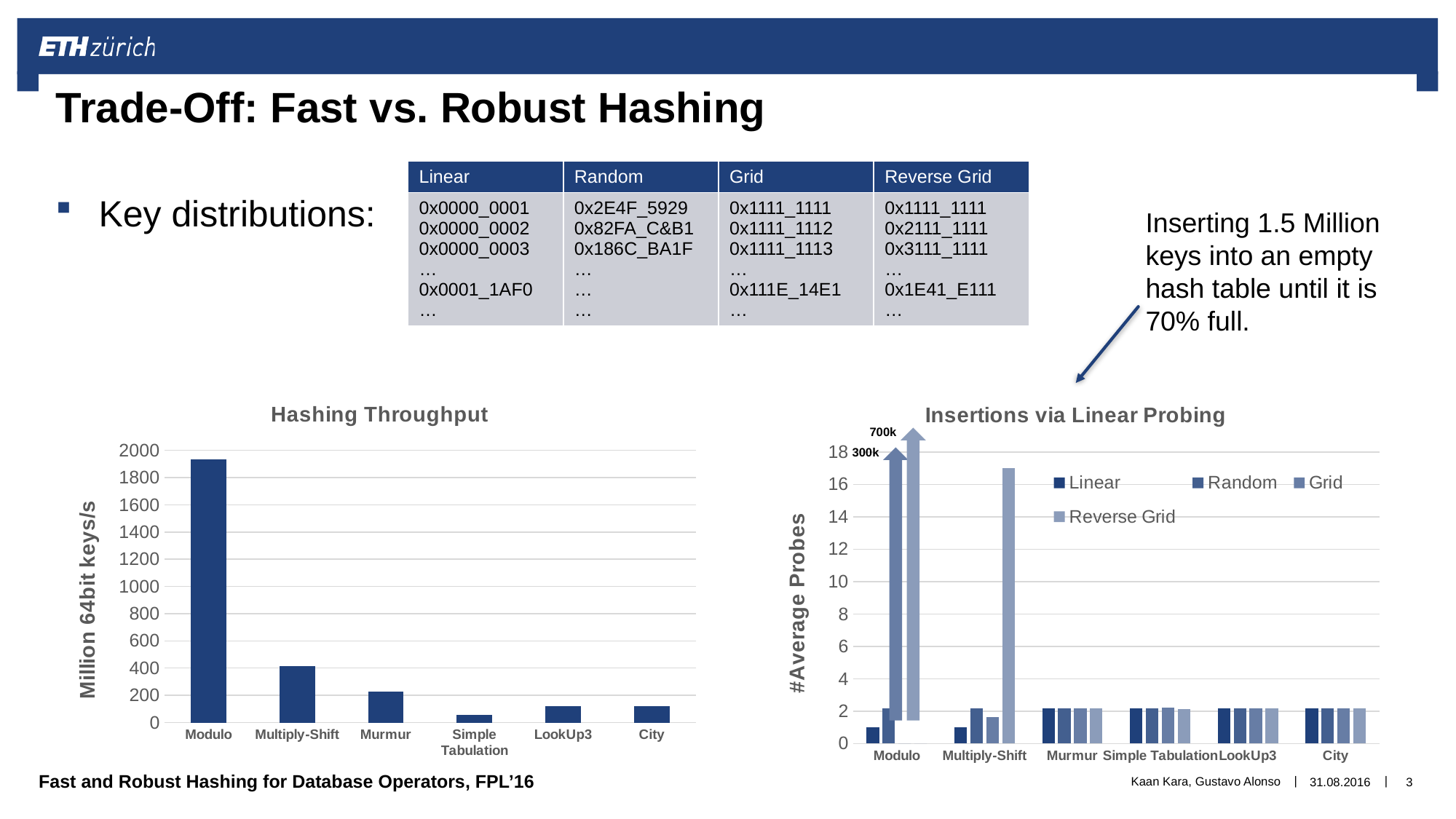
What is the y-axis label of the Insertions via Linear Probing chart? #Average Probes In the Hashing Throughput chart, is the value for Murmur greater or less than 400? less In the Hashing Throughput chart, is the value for Simple Tabulation greater or less than 200? less In the Hashing Throughput chart, is the value for Modulo greater or less than 1800? greater In the Hashing Throughput chart, which hash function has the highest throughput? Modulo How many series does the legend of the Insertions via Linear Probing chart list? 4 What kind of chart is the Hashing Throughput chart? bar chart In the Hashing Throughput chart, which hash function has the lowest throughput? Simple Tabulation In the Hashing Throughput chart, which has the higher throughput, Multiply-Shift or Murmur? Multiply-Shift How many hash functions are shown on the x axis of the Hashing Throughput chart? 6